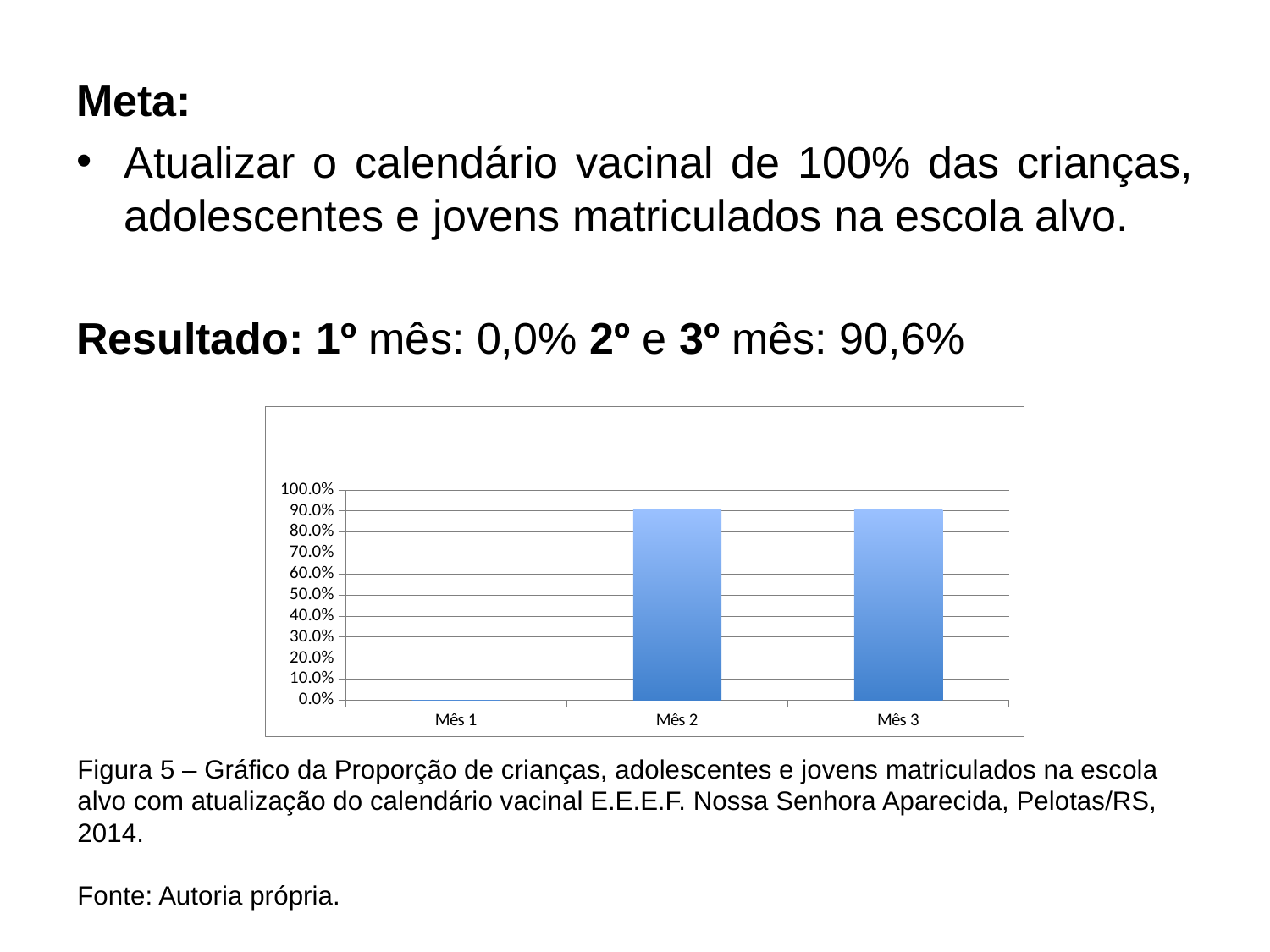
Which month has the lowest value in the chart? Mês 1 Which is larger, the value for Mês 1 or the value for Mês 2? Mês 2 Do the values rise or fall from Mês 1 to Mês 2? rise What kind of chart is shown on the slide? bar chart Is the value for Mês 3 greater or less than 100.0%? less According to the slide, what proportion was reached in the 2º and 3º mês? 90,6% What is the figure number given in the caption below the chart? Figura 5 What is the value for Mês 1 in the chart? 0,0% Is the value for Mês 2 greater or less than 80.0%? greater How many categories (months) are shown on the x axis of the chart? 3 What is the highest tick value shown on the y axis of the chart? 100.0% What is the difference between the value for Mês 2 and the value for Mês 1, using the values stated on the slide? 90,6%